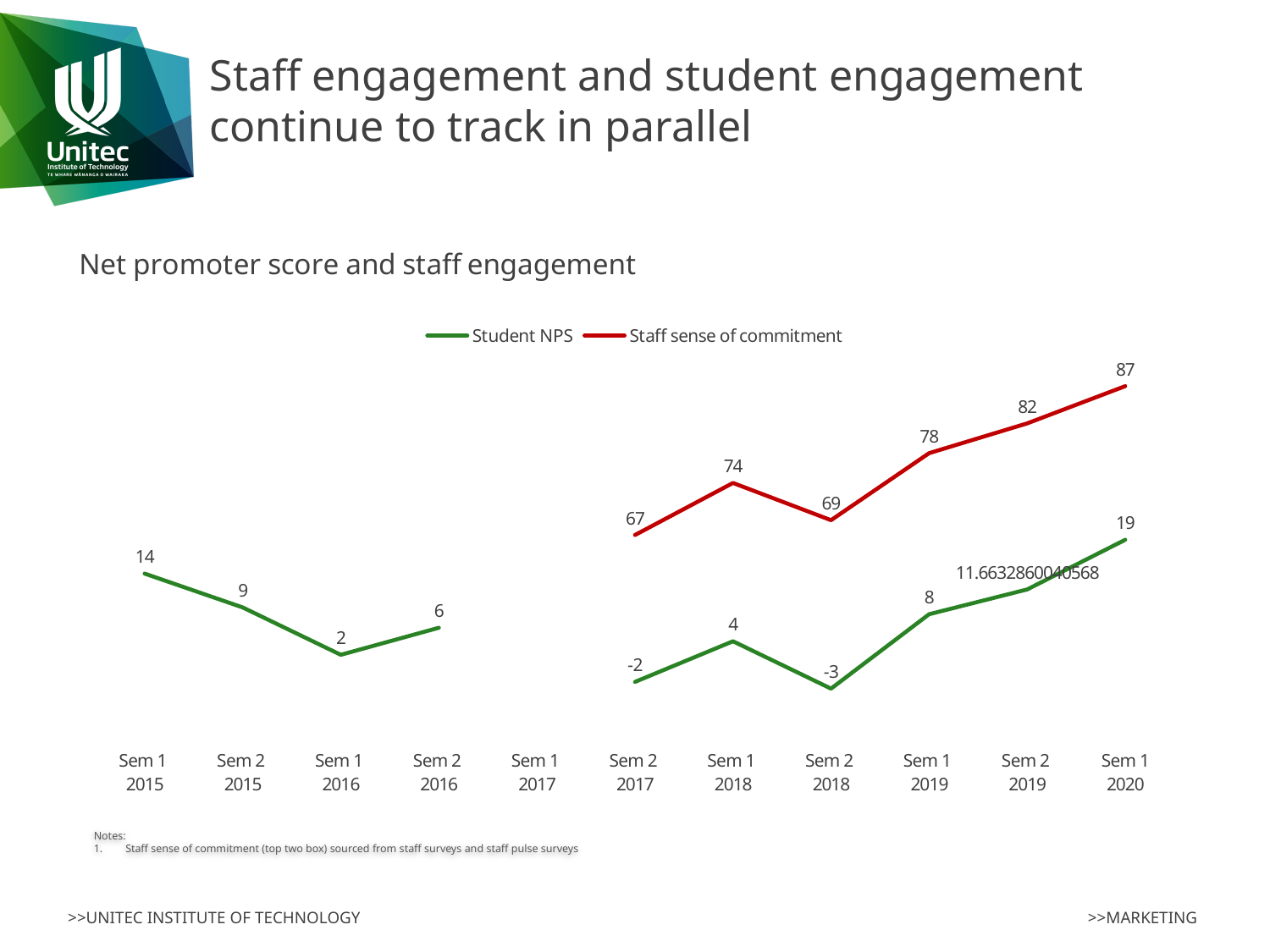
How many series does the legend list? 2 What is the title of the chart? Net promoter score and staff engagement What is the Staff sense of commitment value for Sem 1 2020? 87 What is the Student NPS value for Sem 2 2018? -3 Which semester has the highest Staff sense of commitment value? Sem 1 2020 Which semester has the lowest Student NPS value? Sem 2 2018 How many semester categories are shown on the x axis? 11 What is the difference between the Staff sense of commitment values for Sem 1 2020 and Sem 2 2017? 20 What is the Student NPS value for Sem 1 2015? 14 What type of chart is shown on the slide? line chart Which is larger, the Student NPS for Sem 1 2015 or for Sem 2 2016? Sem 1 2015 What is the Staff sense of commitment value for Sem 2 2017? 67